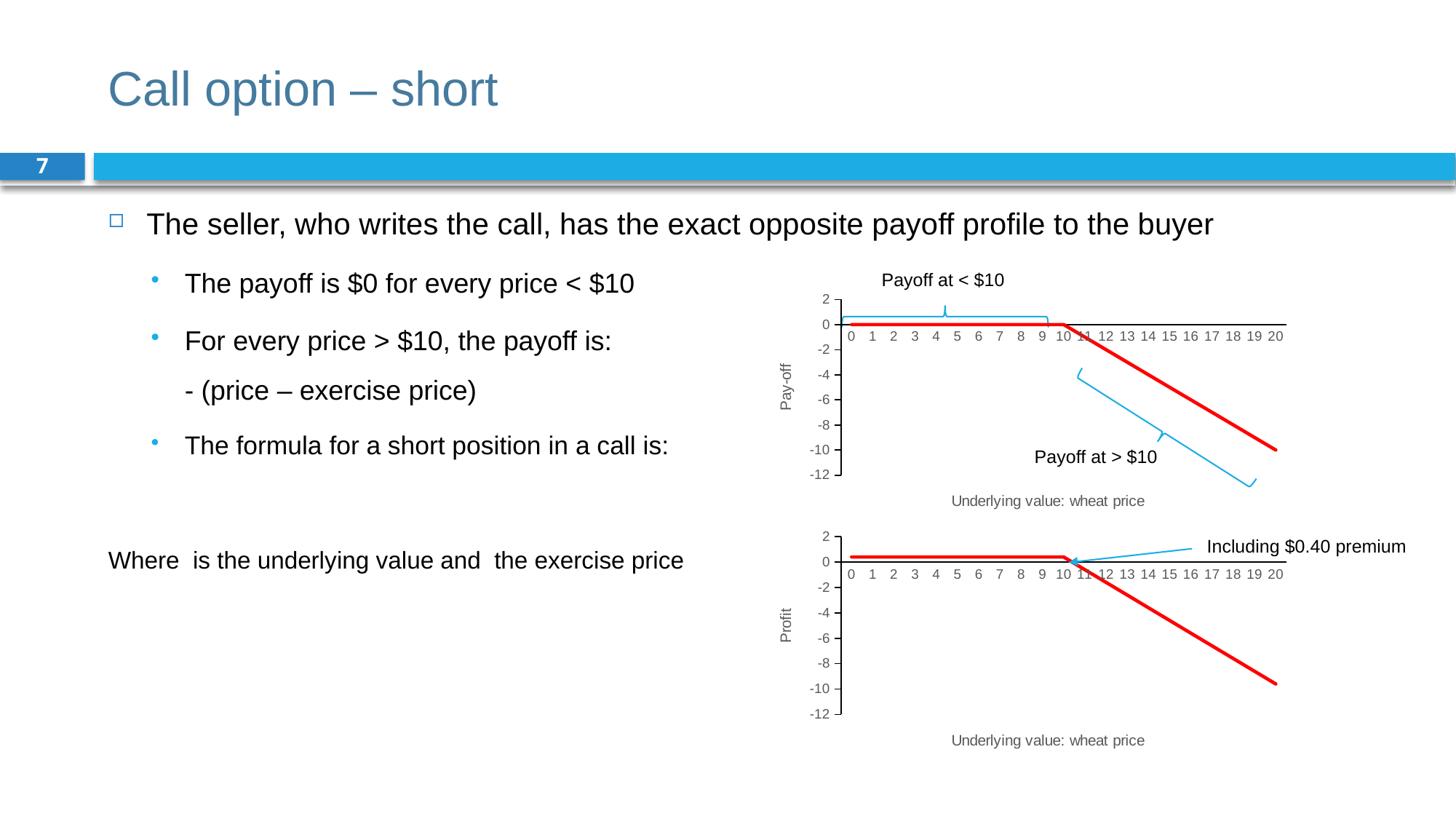
What premium does the annotation on the bottom chart (Profit) say is included? $0.40 What is the x-axis title of the bottom chart (Profit)? Underlying value: wheat price In the top chart (Pay-off), what is the pay-off at a wheat price of 20? -10 In the bottom chart (Profit), is the profit at a wheat price of 5 greater or less than -2? greater In the top chart (Pay-off), which is larger: the pay-off at a wheat price of 5 or at a wheat price of 15? wheat price of 5 What kind of chart is the top chart (Pay-off)? line chart In the top chart (Pay-off), is the pay-off at a wheat price of 15 greater or less than -2? less In the top chart (Pay-off), at which wheat price is the pay-off lowest? 20 In the bottom chart (Profit), do the values rise or fall as the wheat price increases from 12 to 20? fall In the top chart (Pay-off), what is the pay-off at a wheat price of 5? 0 In the bottom chart (Profit), is the profit at a wheat price of 20 greater or less than -8? less In the top chart (Pay-off), do the values rise or fall as the wheat price increases from 10 to 20? fall